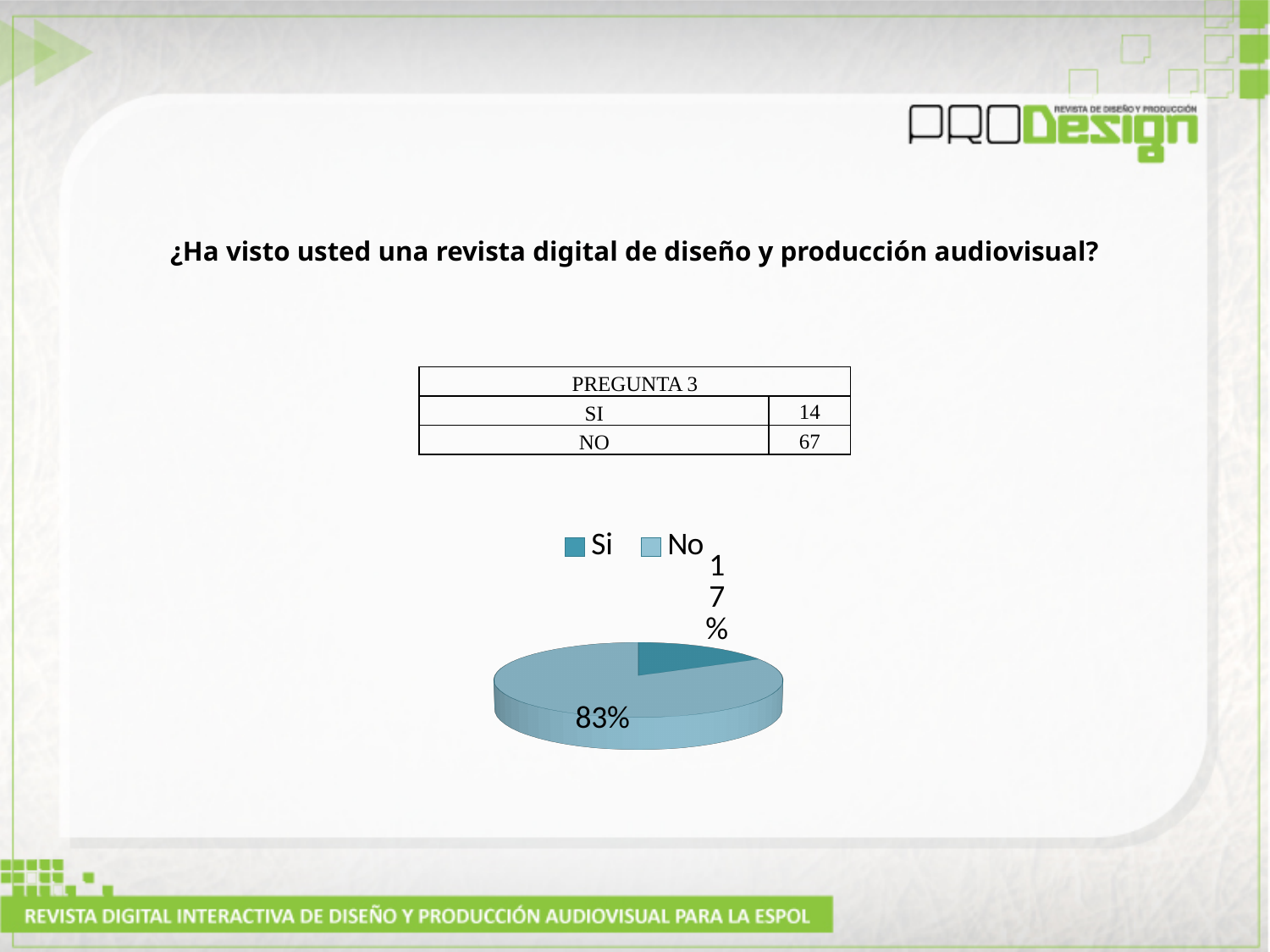
Which slice of the pie chart is the smallest? Si What is the difference in percentage points between the "No" slice and the "Si" slice? 66% What percentage of the pie chart is labelled for the "No" slice? 83% What kind of chart is shown on the slide? pie chart Which slice of the pie chart is the largest? No Which legend entry is shown in the darker teal colour? Si How many entries does the legend of the pie chart list? 2 What are the two legend entries of the pie chart? Si and No Which is larger in the pie chart, the "Si" slice or the "No" slice? No How many slices does the pie chart have? 2 What share of the pie does the "No" slice represent? 83% What percentage of the pie chart is labelled for the "Si" slice? 17%